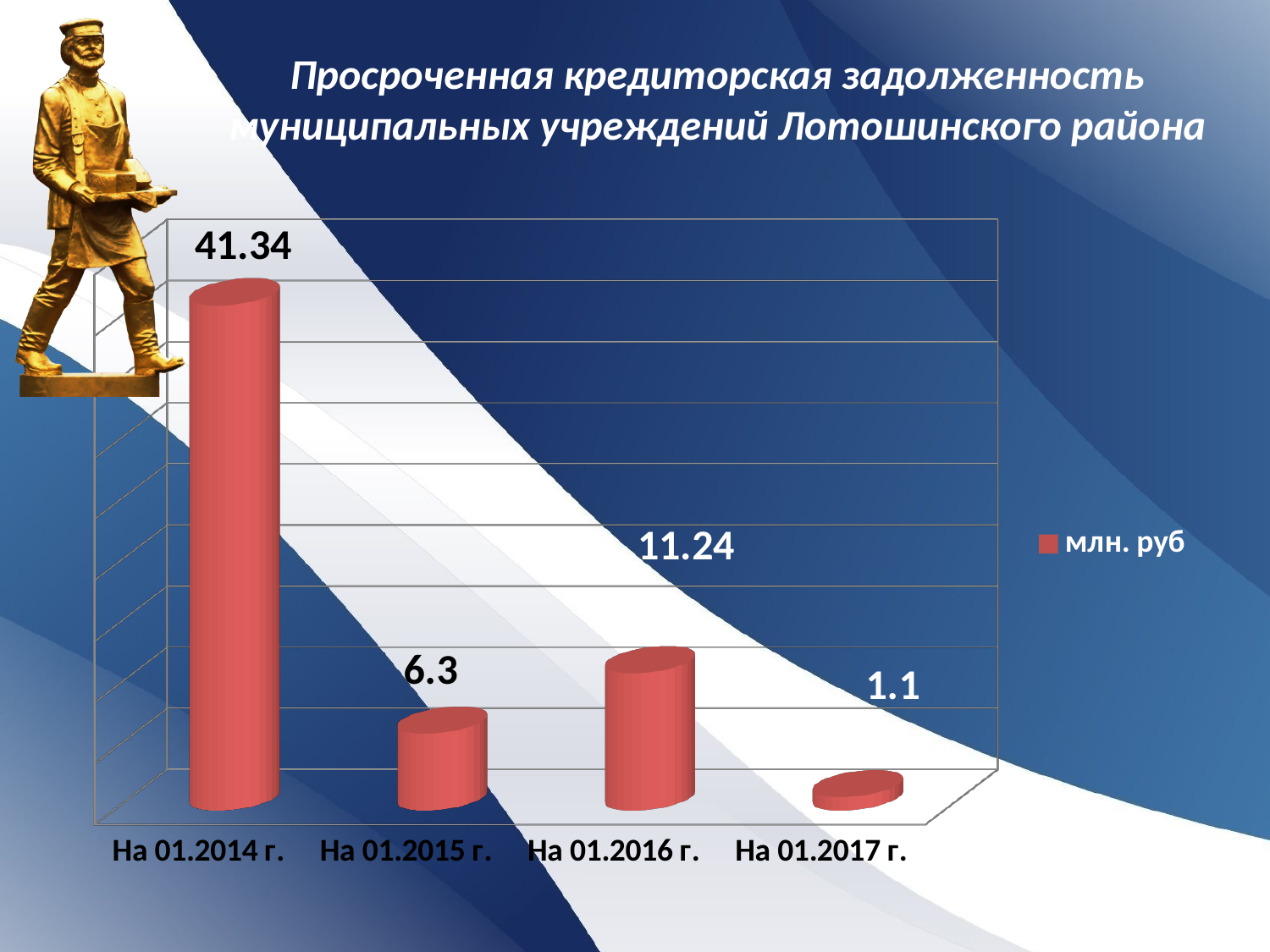
What series name is shown in the legend? млн. руб How many series does the legend list? 1 What is the value for На 01.2017 г.? 1.1 What is the value for На 01.2016 г.? 11.24 What kind of chart is shown on the slide? bar chart Which is larger, the value for На 01.2015 г. or На 01.2016 г.? На 01.2016 г. What is the difference between the values for На 01.2014 г. and На 01.2015 г.? 35.04 What is the difference between the values for На 01.2016 г. and На 01.2017 г.? 10.14 Which category has the highest value? На 01.2014 г. How many categories are shown on the chart? 4 What is the value for На 01.2014 г.? 41.34 Which category has the lowest value? На 01.2017 г.